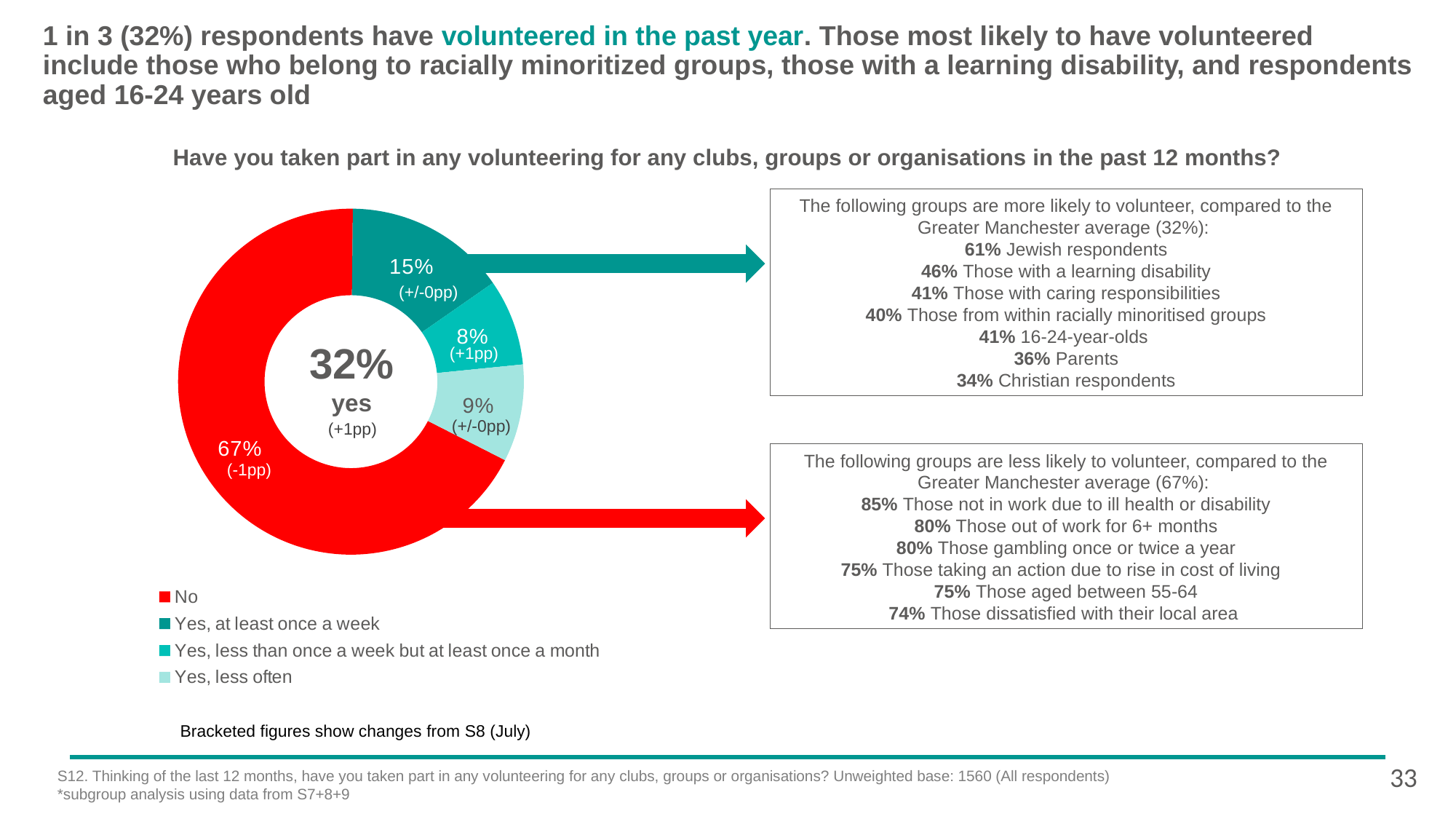
How many categories does the legend list? 4 Which category has the largest share of the pie? No What kind of chart is shown on the slide? Pie chart (doughnut) What total percentage of respondents said yes, as shown in the centre of the chart? 32% Which is larger: the share for "Yes, less often" or the share for "Yes, less than once a week but at least once a month"? Yes, less often What percentage of respondents volunteered less than once a week but at least once a month? 8% What change from S8 (July) is shown in brackets for the "No" category? -1pp What percentage of respondents answered "No" to volunteering in the past 12 months? 67% What percentage of respondents volunteered less often? 9% What is the difference between the "No" share and the "Yes, at least once a week" share? 52 percentage points Which category has the smallest share of the pie? Yes, less than once a week but at least once a month What percentage of respondents volunteered at least once a week? 15%